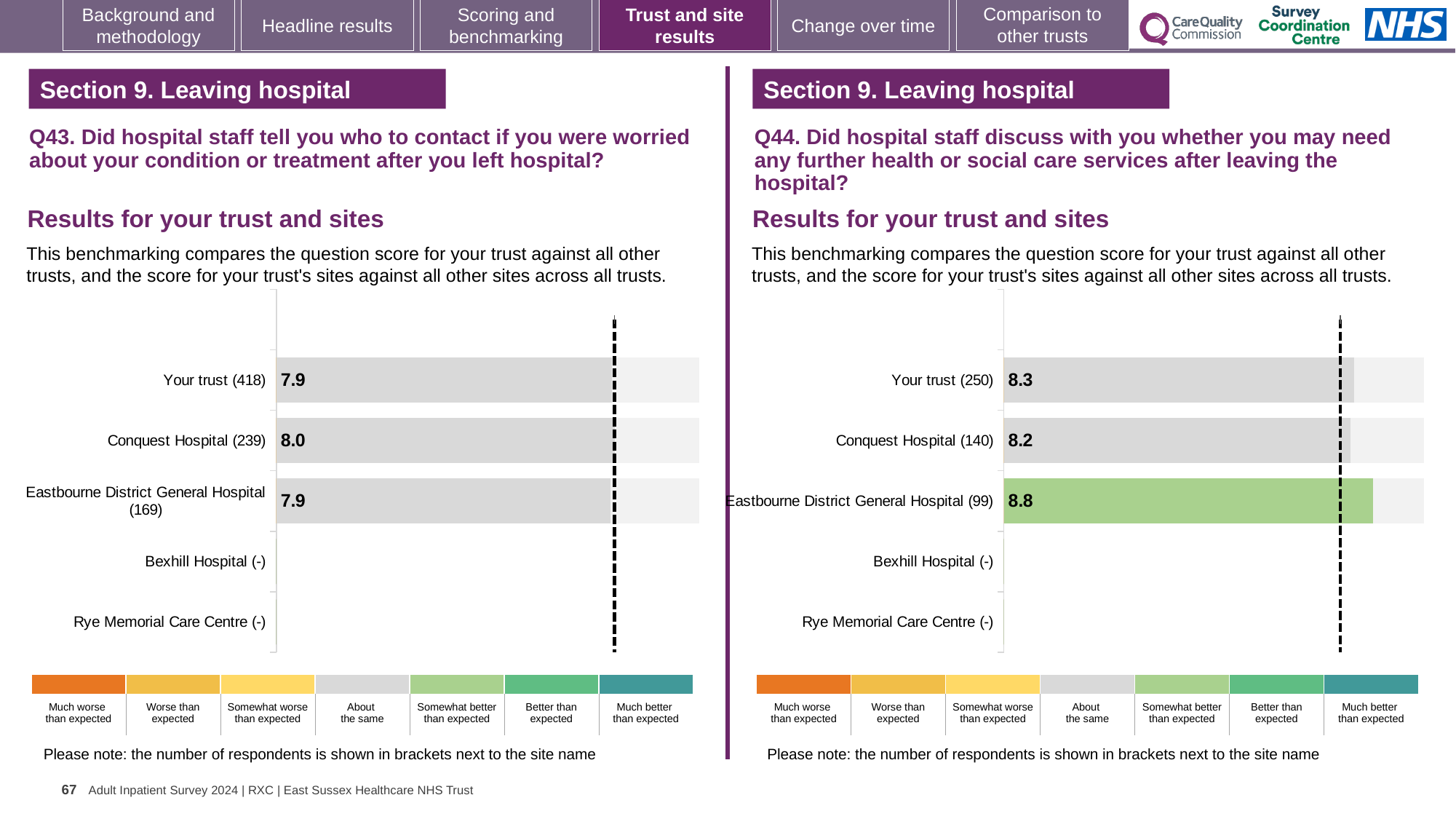
In the Q44 chart on the right, what is the difference between the Eastbourne District General Hospital score and the Conquest Hospital score? 0.6 In the Q44 chart on the right, which site has the highest score? Eastbourne District General Hospital What kind of chart is used for the Q44 results on the right? Bar chart In the Q44 chart on the right, how many respondents are shown in brackets for Eastbourne District General Hospital? 99 In the Q43 chart on the left, what is the score for Your trust? 7.9 In the Q44 chart on the right, what is the difference between the Your trust score and the Conquest Hospital score? 0.1 In the Q44 chart on the right, what is the score for Eastbourne District General Hospital? 8.8 In the Q43 chart on the left, which is larger: the score for Conquest Hospital or the score for Eastbourne District General Hospital? Conquest Hospital In the Q44 chart on the right, which site's bar is coloured green (somewhat better than expected)? Eastbourne District General Hospital In the Q44 chart on the right, what is the score for Your trust? 8.3 In the Q43 chart on the left, what is the score for Conquest Hospital? 8.0 How many site/trust categories are listed on the y axis of the Q43 chart on the left? 5